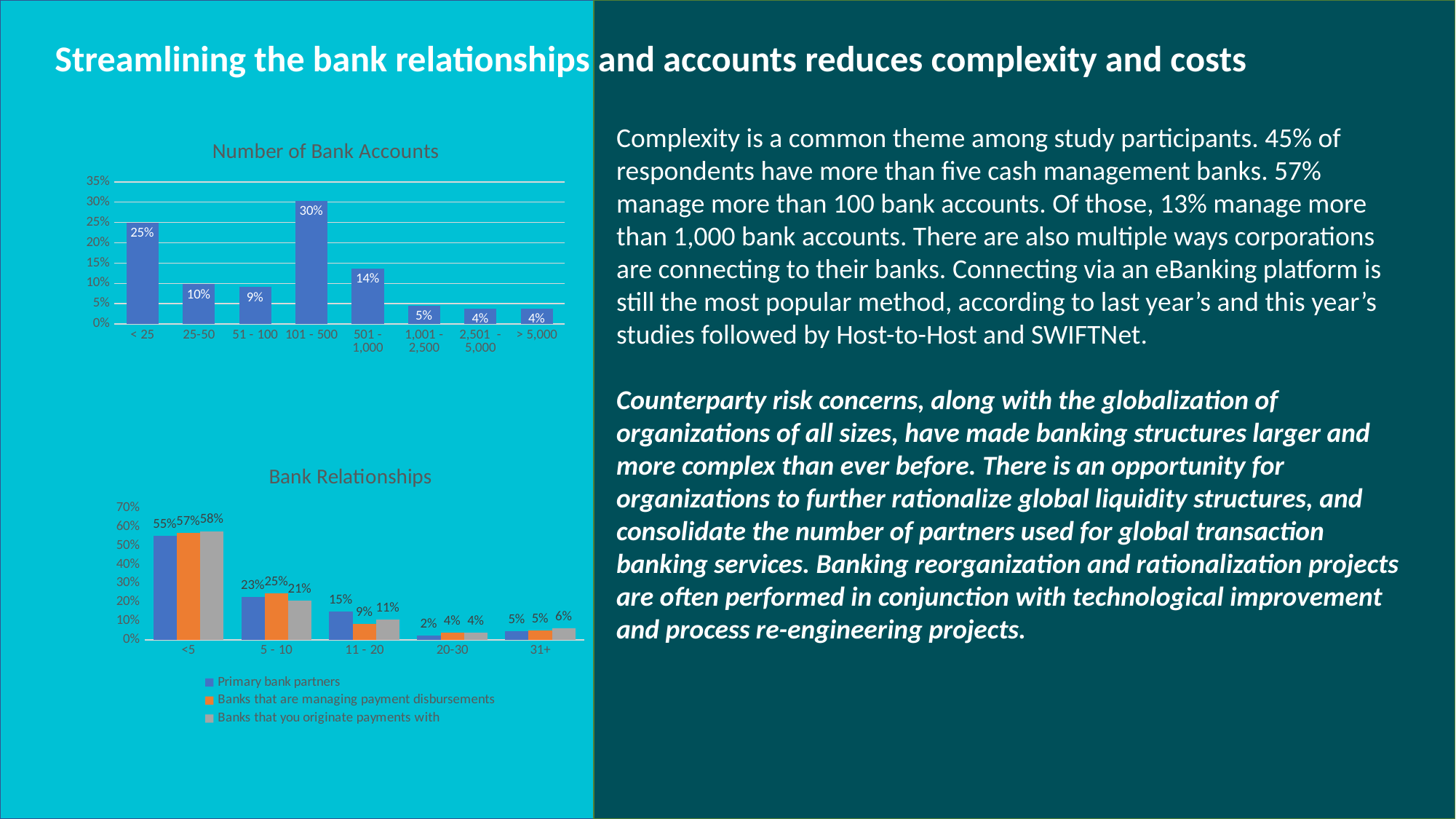
What kind of chart is the "Number of Bank Accounts" chart? bar chart In the "Bank Relationships" chart, how many series does the legend list? 3 In the "Bank Relationships" chart, what is the value for "Primary bank partners" in the "11 - 20" category? 15% In the "Number of Bank Accounts" chart, what is the difference between the values for "< 25" and "25-50"? 15% In the "Bank Relationships" chart, which category has the highest value for "Banks that you originate payments with"? <5 In the "Number of Bank Accounts" chart, which category has the highest value? 101 - 500 In the "Bank Relationships" chart, what is the difference between "Primary bank partners" and "Banks that are managing payment disbursements" in the "11 - 20" category? 6% In the "Bank Relationships" chart, which is larger for the "5 - 10" category: "Banks that are managing payment disbursements" or "Banks that you originate payments with"? Banks that are managing payment disbursements In the "Number of Bank Accounts" chart, is the value for "501 - 1,000" greater or less than 10%? greater In the "Bank Relationships" chart, which series is shown in orange? Banks that are managing payment disbursements In the "Number of Bank Accounts" chart, how many categories are shown on the x axis? 8 In the "Number of Bank Accounts" chart, what is the value for the "101 - 500" category? 30%